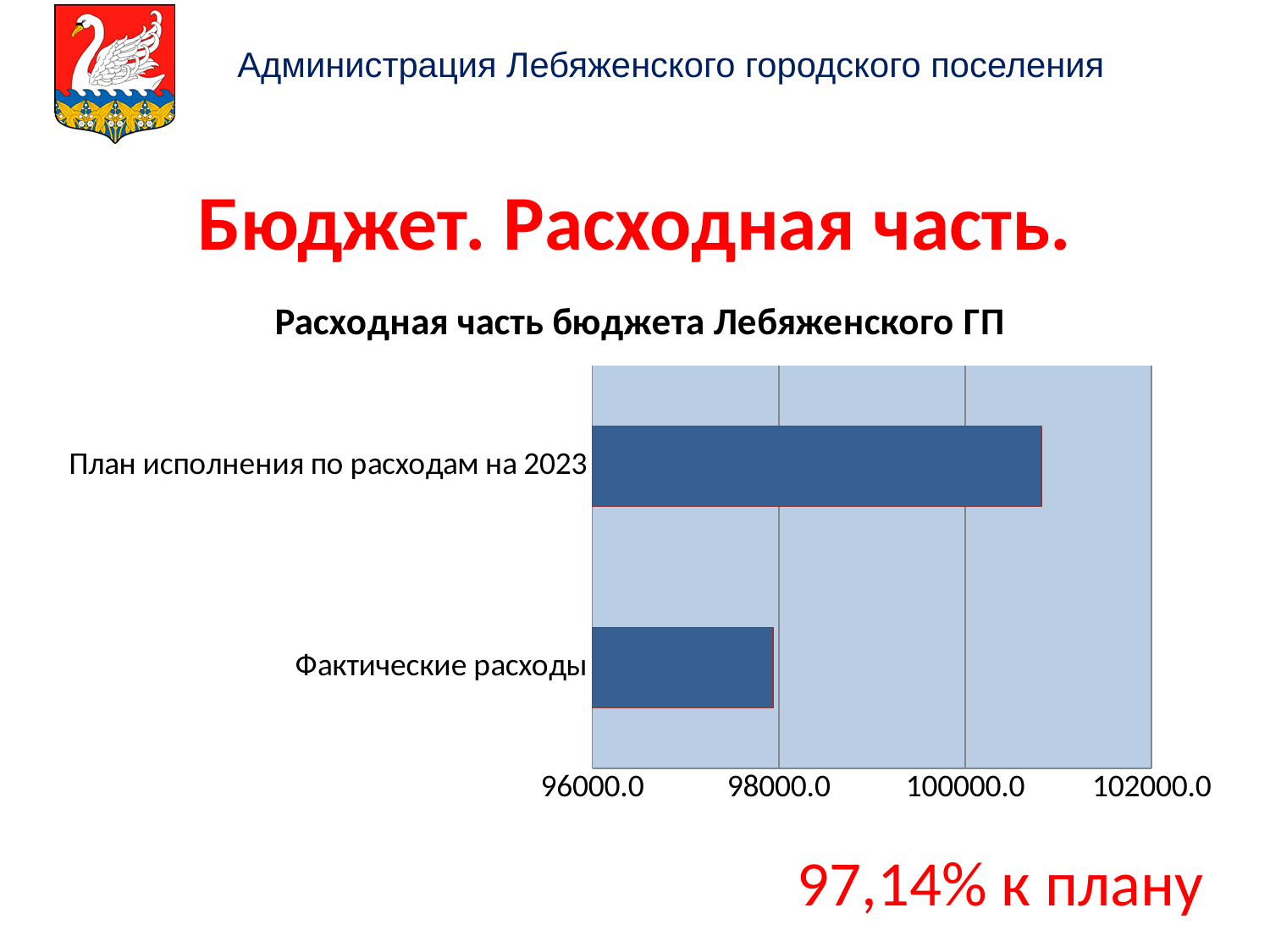
Is the value for Фактические расходы greater or less than 100000.0? less Is the value for План исполнения по расходам на 2023 greater or less than 102000.0? less Is the value for Фактические расходы greater or less than 96000.0? greater How many categories are plotted in the chart? 2 Which category has the highest value? План исполнения по расходам на 2023 Which is larger, the value for План исполнения по расходам на 2023 or the value for Фактические расходы? План исполнения по расходам на 2023 What kind of chart is shown on the slide? bar chart What is the title of the chart? Расходная часть бюджета Лебяженского ГП Which category has the lowest value? Фактические расходы What is the lowest value shown on the horizontal axis of the chart? 96000.0